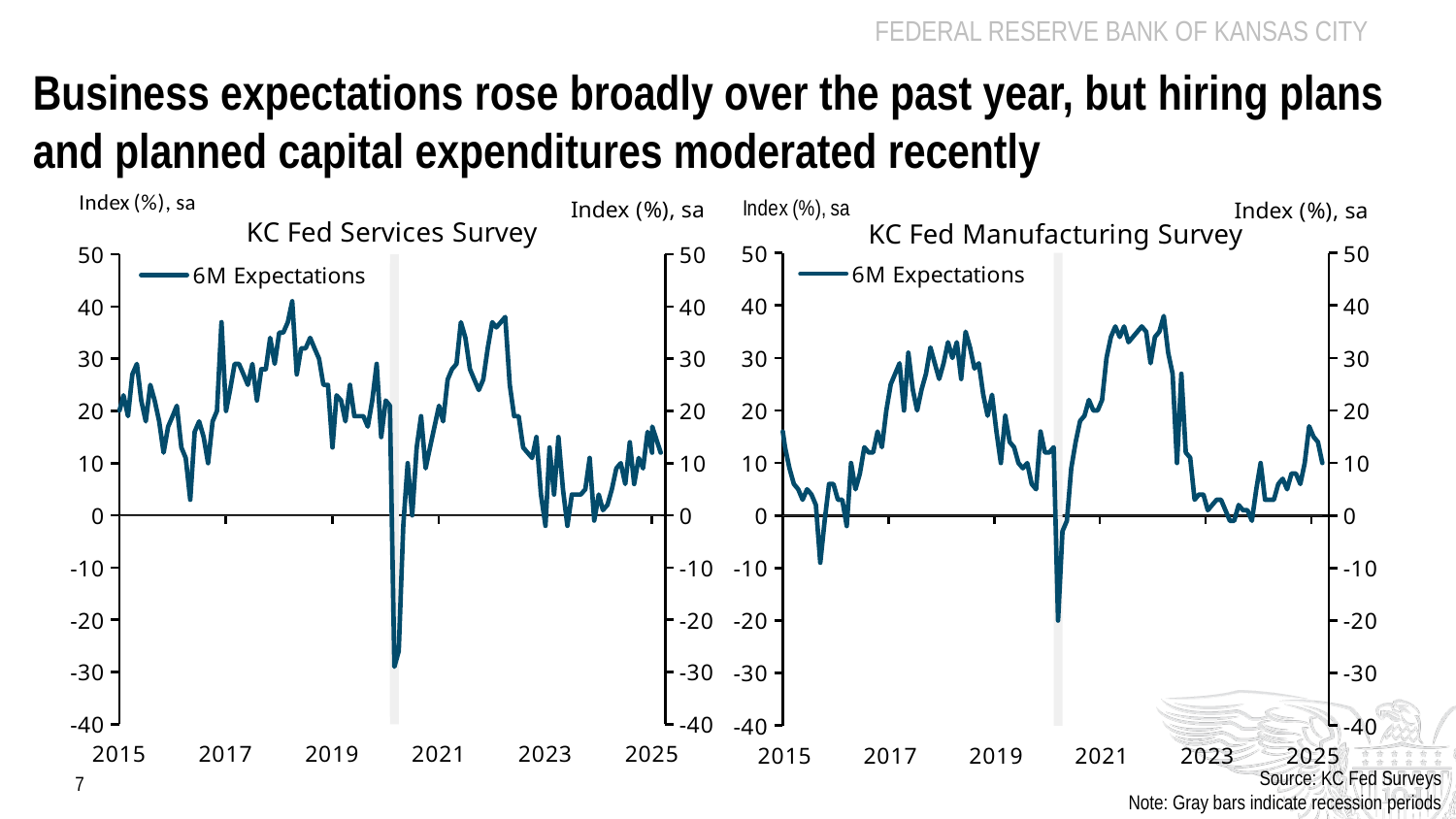
What is the y-axis label on the KC Fed Services Survey chart? Index (%), sa In the KC Fed Manufacturing Survey chart, are the 6M Expectations values during 2023 greater or less than 10? less How many charts are shown on the slide? 2 What is the name of the series plotted in the KC Fed Manufacturing Survey chart? 6M Expectations How many series does the legend of the KC Fed Services Survey chart list? 1 In the KC Fed Services Survey chart, is the peak value of 6M Expectations in 2018 greater or less than 30? greater In the KC Fed Manufacturing Survey chart, do 6M Expectations rise or fall between 2016 and 2018? rise What kind of chart is the KC Fed Manufacturing Survey chart? line chart In the KC Fed Manufacturing Survey chart, is the peak value of 6M Expectations around 2021-2022 greater or less than 30? greater In the KC Fed Manufacturing Survey chart, do 6M Expectations rise or fall between 2022 and 2023? fall What kind of chart is the KC Fed Services Survey chart? line chart